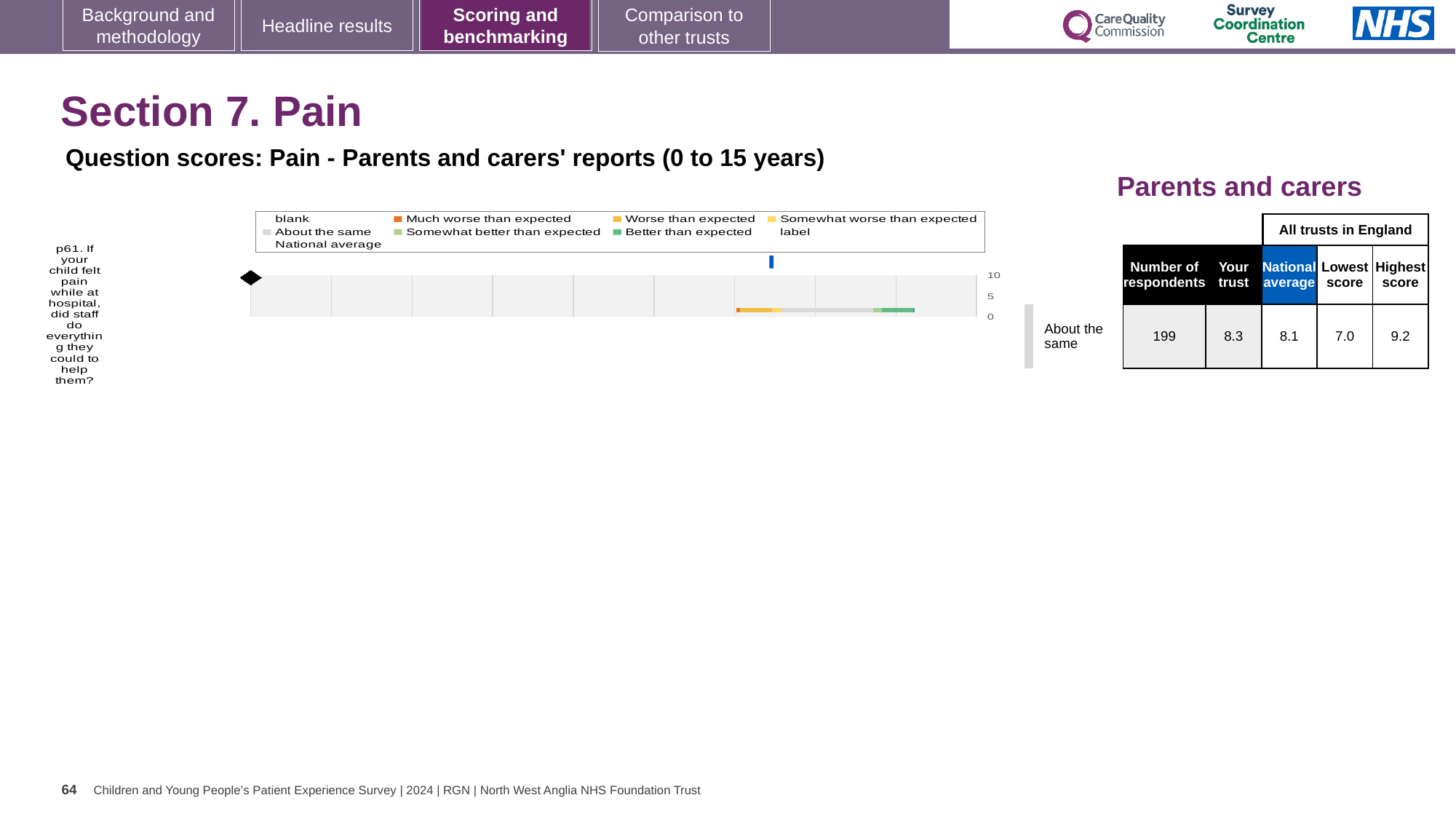
What is the difference between the trust's score and the national average for question p61? 0.2 What kind of chart is used to show the p61 question score? bar chart What is the difference between the highest and lowest scores among all trusts in England for question p61? 2.2 Which is larger for question p61, the trust's score or the national average? the trust's score Which benchmark category is the trust's score for p61 placed in? About the same How many survey questions are plotted in the chart? 1 What is the national average score for question p61? 8.1 What is the lowest score among all trusts in England for question p61? 7.0 What is the trust's score for question p61? 8.3 How many respondents answered question p61? 199 What is the highest score among all trusts in England for question p61? 9.2 What is the highest value shown on the chart's score axis? 10